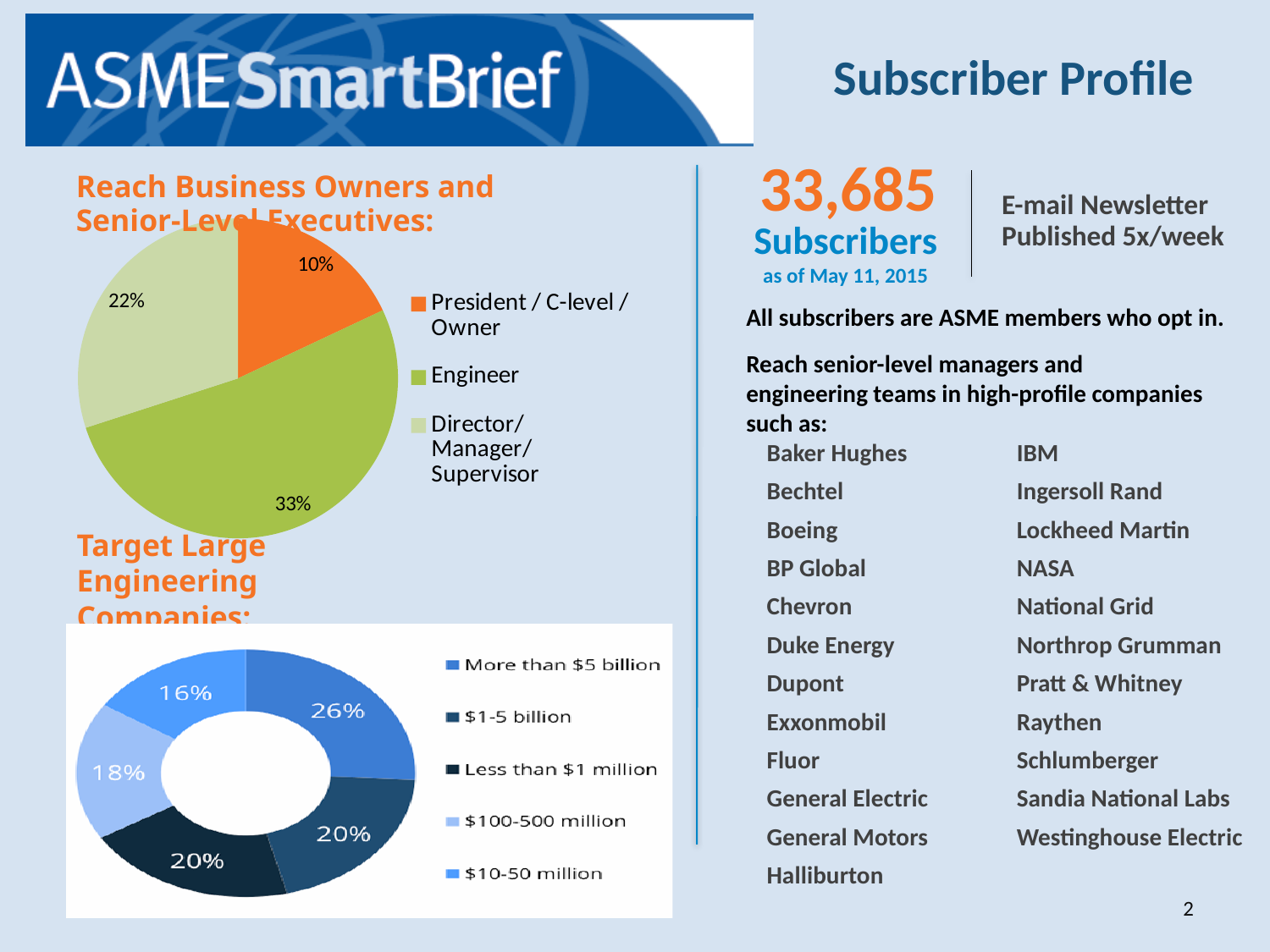
In the pie chart at the top left, what percentage is shown for Engineer? 33% What kind of chart is the chart at the top left of the slide, under 'Reach Business Owners and Senior-Level Executives'? Pie chart In the pie chart at the top left, what percentage is shown for Director/Manager/Supervisor? 22% In the pie chart at the top left, how many categories does the legend list? 3 In the doughnut chart at the bottom left, what percentage is shown for '$10-50 million'? 16% In the pie chart at the top left, which category has the largest share? Engineer In the doughnut chart at the bottom left, what percentage is shown for 'More than $5 billion'? 26% In the doughnut chart at the bottom left, what is the difference in percentage points between 'More than $5 billion' and '$10-50 million'? 10 percentage points What kind of chart is the chart at the bottom left of the slide, under 'Target Large Engineering Companies'? Doughnut chart In the doughnut chart at the bottom left, how many categories does the legend list? 5 In the doughnut chart at the bottom left, which category has the largest share? More than $5 billion In the pie chart at the top left, what percentage is shown for President / C-level / Owner? 10%